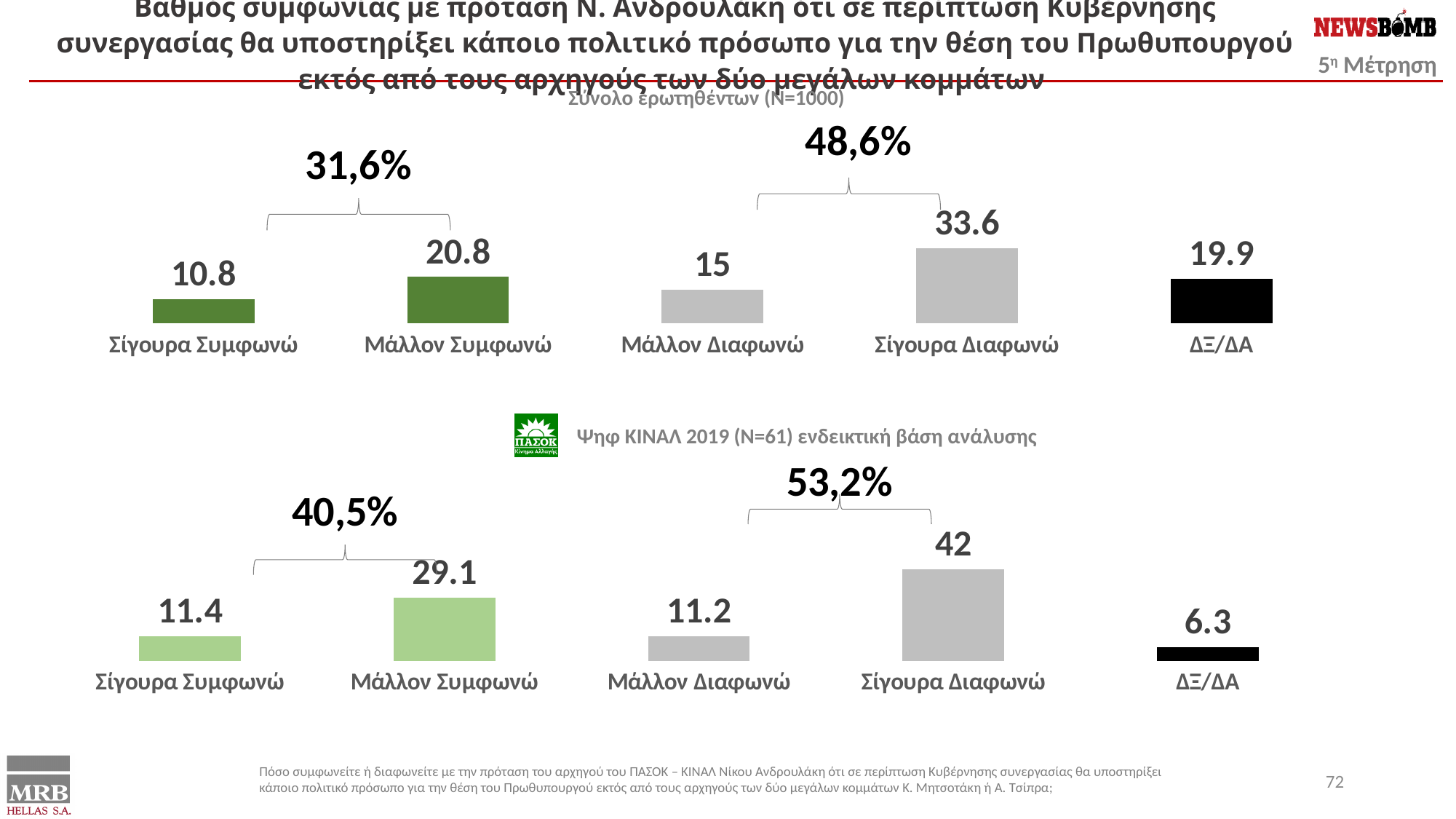
In the top chart (Σύνολο ερωτηθέντων, N=1000), what is the value for Σίγουρα Διαφωνώ? 33.6 In the bottom chart (Ψηφ ΚΙΝΑΛ 2019, N=61), which is larger: Σίγουρα Συμφωνώ or Μάλλον Διαφωνώ? Σίγουρα Συμφωνώ How many categories are shown in the top chart (Σύνολο ερωτηθέντων, N=1000)? 5 In the bottom chart (Ψηφ ΚΙΝΑΛ 2019, N=61), which category has the lowest value? ΔΞ/ΔΑ In the top chart (Σύνολο ερωτηθέντων, N=1000), which category has the highest value? Σίγουρα Διαφωνώ In the bottom chart (Ψηφ ΚΙΝΑΛ 2019, N=61), what is the value for Μάλλον Συμφωνώ? 29.1 In the top chart (Σύνολο ερωτηθέντων, N=1000), what is the value for ΔΞ/ΔΑ? 19.9 What kind of chart is used on this slide? Bar chart In the bottom chart (Ψηφ ΚΙΝΑΛ 2019, N=61), what is the difference between Σίγουρα Διαφωνώ and Μάλλον Συμφωνώ? 12.9 In the bottom chart (Ψηφ ΚΙΝΑΛ 2019, N=61), what is the value for ΔΞ/ΔΑ? 6.3 In the top chart (Σύνολο ερωτηθέντων, N=1000), which category has the lowest value? Σίγουρα Συμφωνώ In the top chart (Σύνολο ερωτηθέντων, N=1000), what is the difference between Σίγουρα Διαφωνώ and Μάλλον Διαφωνώ? 18.6